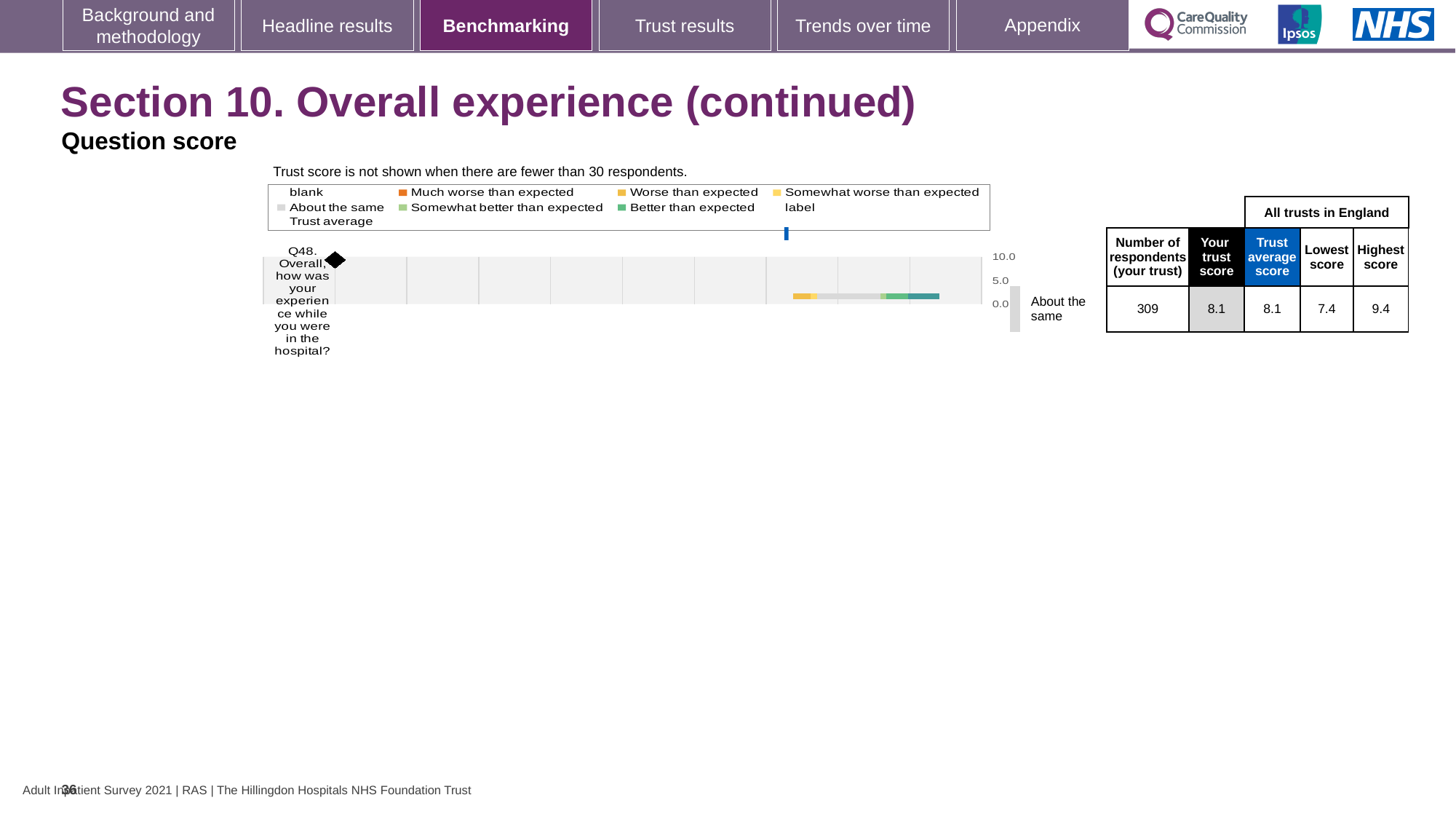
What is the highest tick value shown on the chart's score axis? 10.0 What kind of chart is used to show the Q48 question score? bar chart What is the 'Lowest score' among all trusts in England for Q48? 7.4 What is the 'Your trust score' value for Q48? 8.1 Which benchmark category is your trust's Q48 score placed in? About the same What is the difference between the highest score and the lowest score for Q48? 2.0 What is the 'Highest score' among all trusts in England for Q48? 9.4 How many questions are plotted in the question score chart? 1 How many respondents from your trust answered Q48? 309 Which question is plotted in the question score chart? Q48. Overall, how was your experience while you were in the hospital? What is the 'Trust average score' for Q48? 8.1 Is your trust score for Q48 higher than, lower than, or the same as the trust average score? the same